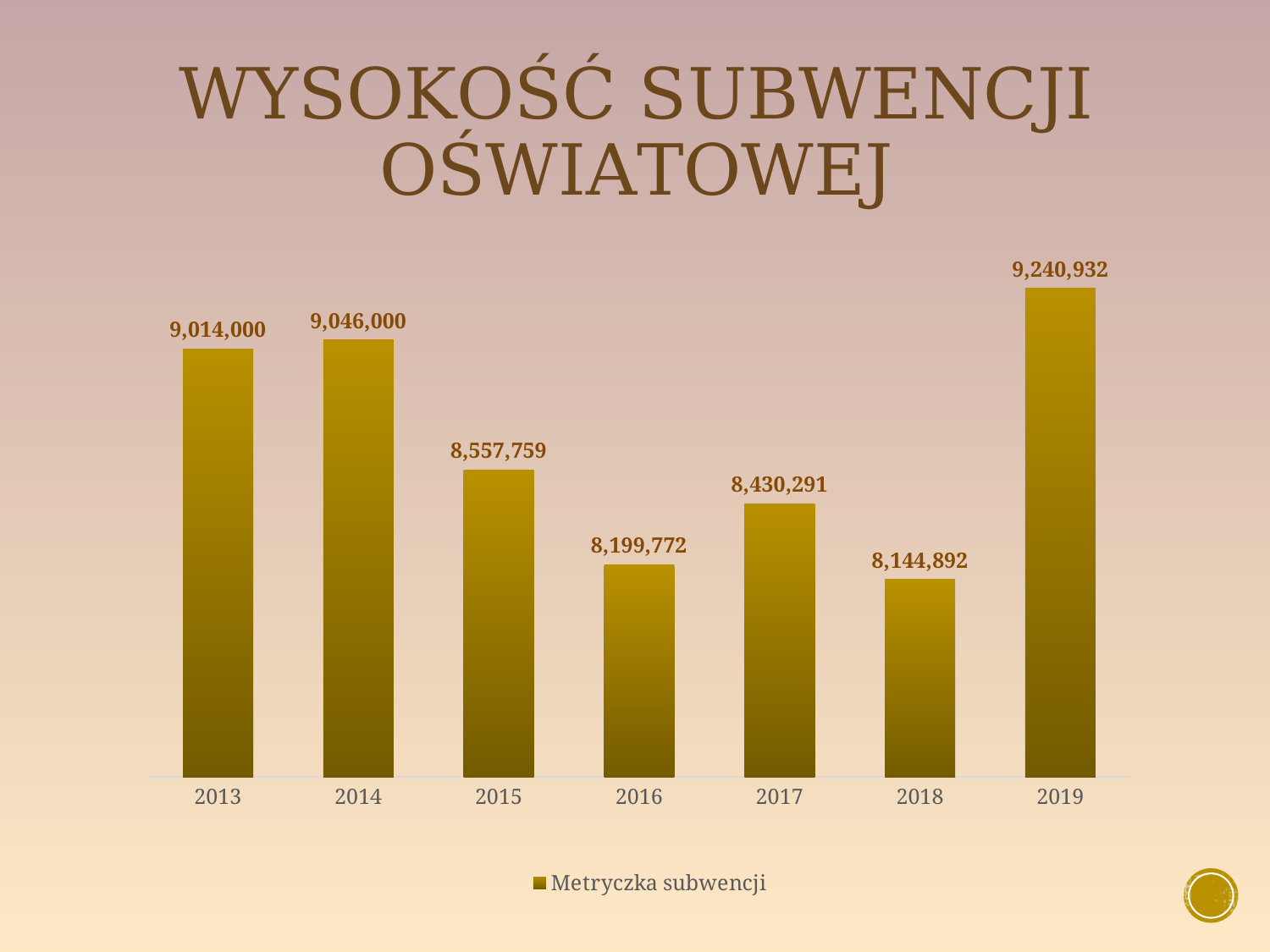
Which year has the lowest value? 2018 Does the value rise or fall from 2017 to 2018? fall How many series does the legend list? 1 What is the value for 2013? 9,014,000 How many years are shown on the x axis? 7 Which is larger, the value for 2015 or the value for 2017? 2015 What is the difference between the values for 2015 and 2016? 357,987 What is the value for 2019? 9,240,932 What is the value for 2016? 8,199,772 Which year has the highest value? 2019 What kind of chart is shown on the slide? bar chart What is the difference between the values for 2019 and 2018? 1,096,040